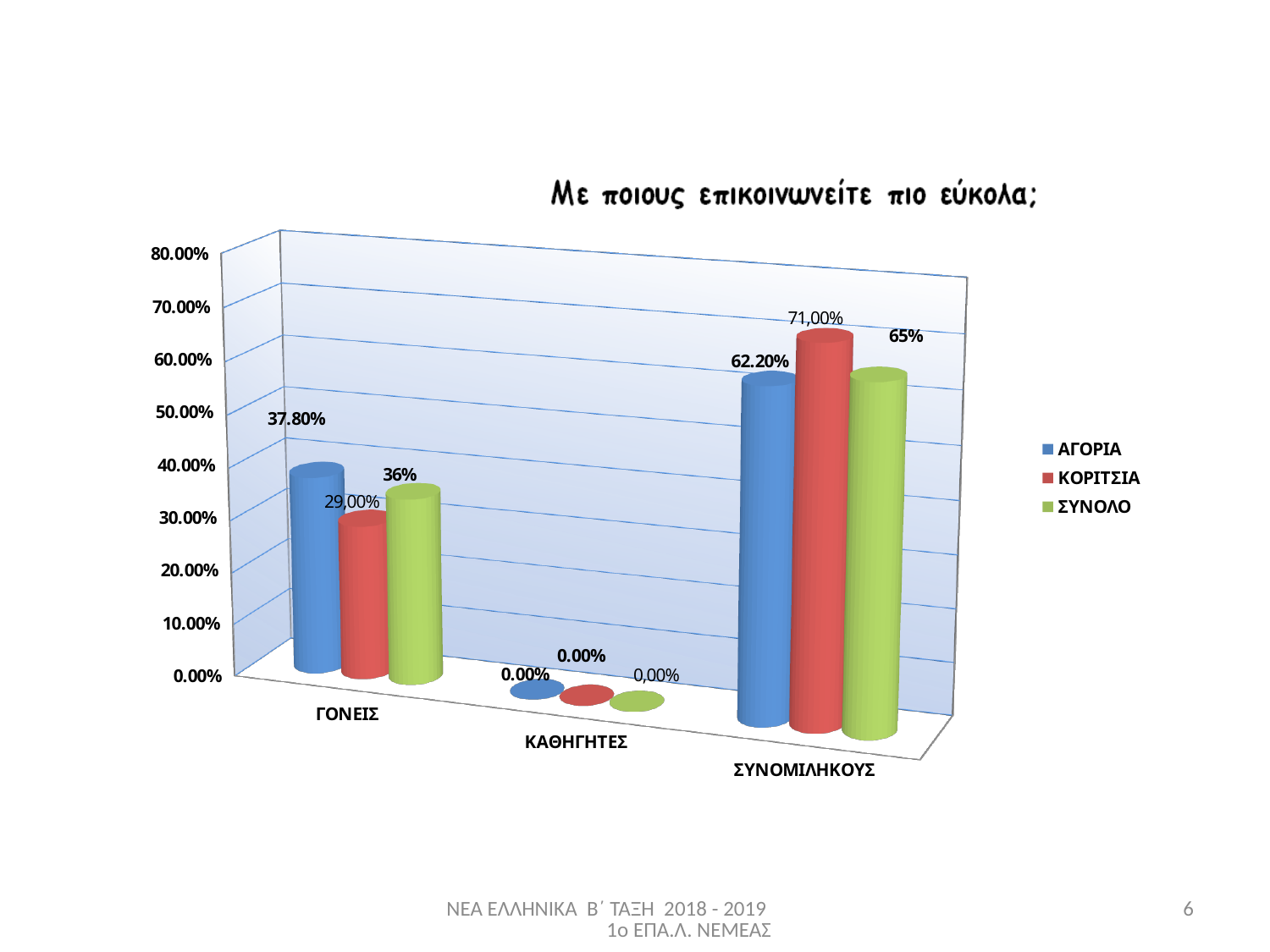
How many categories are shown on the x axis? 3 What is the value for ΑΓΟΡΙΑ in the ΚΑΘΗΓΗΤΕΣ category? 0.00% Is the ΣΥΝΟΛΟ value for ΣΥΝΟΜΙΛΗΚΟΥΣ greater or less than 60.00%? greater How many series does the legend list? 3 What is the difference between the ΑΓΟΡΙΑ values for ΣΥΝΟΜΙΛΗΚΟΥΣ and ΓΟΝΕΙΣ? 24.40% Which category has the highest value for the ΚΟΡΙΤΣΙΑ series? ΣΥΝΟΜΙΛΗΚΟΥΣ What is the value for ΣΥΝΟΛΟ in the ΓΟΝΕΙΣ category? 36% What is the value for ΚΟΡΙΤΣΙΑ in the ΣΥΝΟΜΙΛΗΚΟΥΣ category? 71,00% Which is larger in the ΓΟΝΕΙΣ category: the ΑΓΟΡΙΑ value or the ΚΟΡΙΤΣΙΑ value? ΑΓΟΡΙΑ What kind of chart is shown on the slide? Bar chart What is the value for ΑΓΟΡΙΑ in the ΓΟΝΕΙΣ category? 37.80% Which category has the lowest value for the ΣΥΝΟΛΟ series? ΚΑΘΗΓΗΤΕΣ